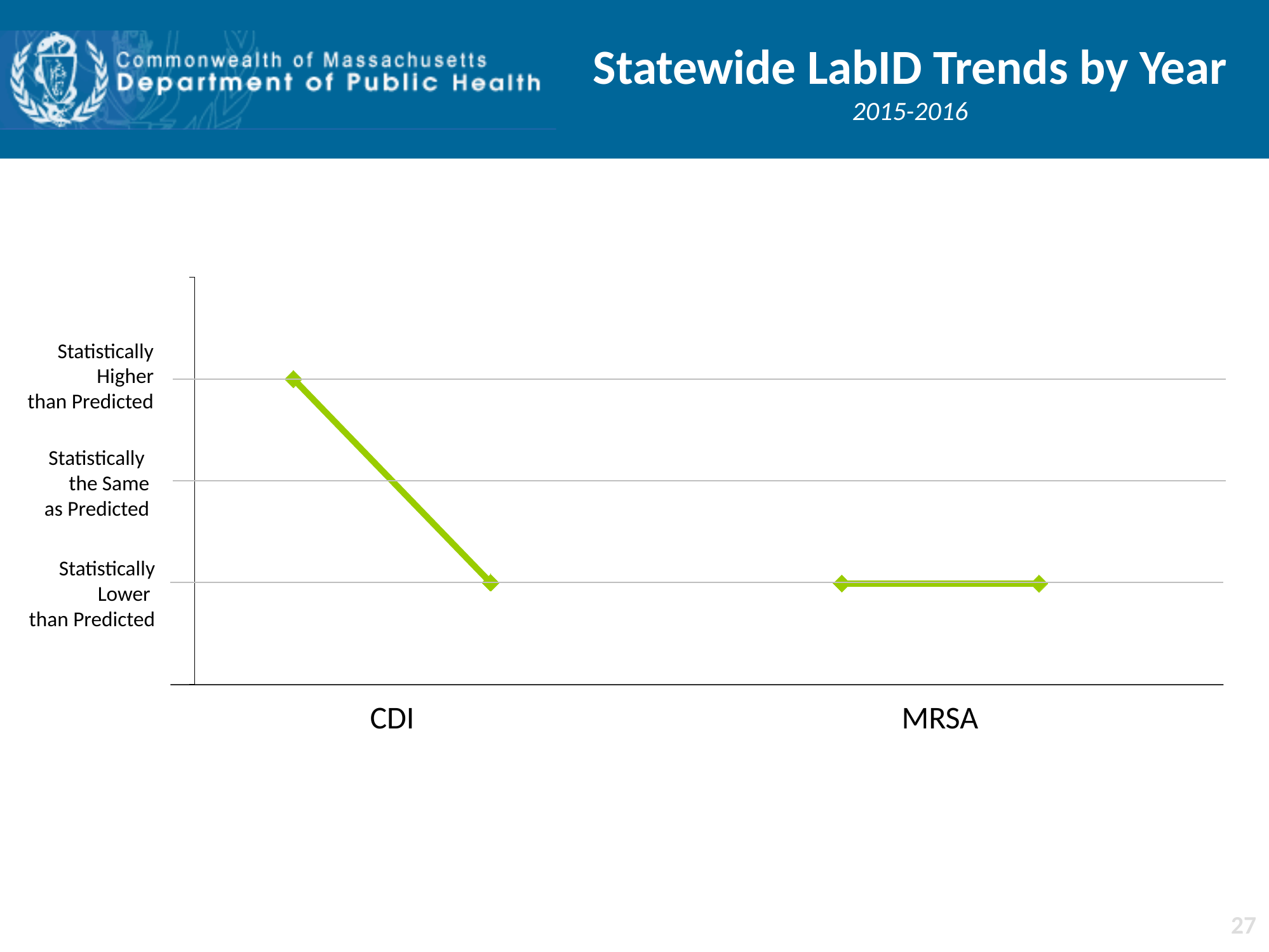
Which two categories are shown on the x axis? CDI and MRSA How many levels are labelled on the y axis of the chart? 3 What is the title of the chart on the slide? Statewide LabID Trends by Year Does the CDI line rise or fall from its first point to its second point? Falls What kind of chart is shown on the slide? Line chart How many categories are labelled on the x axis of the chart? 2 At which level do the MRSA points sit on the y axis? Statistically Lower than Predicted At which level does the second CDI point sit on the y axis? Statistically Lower than Predicted Does the MRSA line rise, fall, or stay flat between its two points? Stays flat At which level does the first CDI point sit on the y axis? Statistically Higher than Predicted Which category starts at a higher level on the y axis, CDI or MRSA? CDI What years does the chart subtitle say the trends cover? 2015-2016